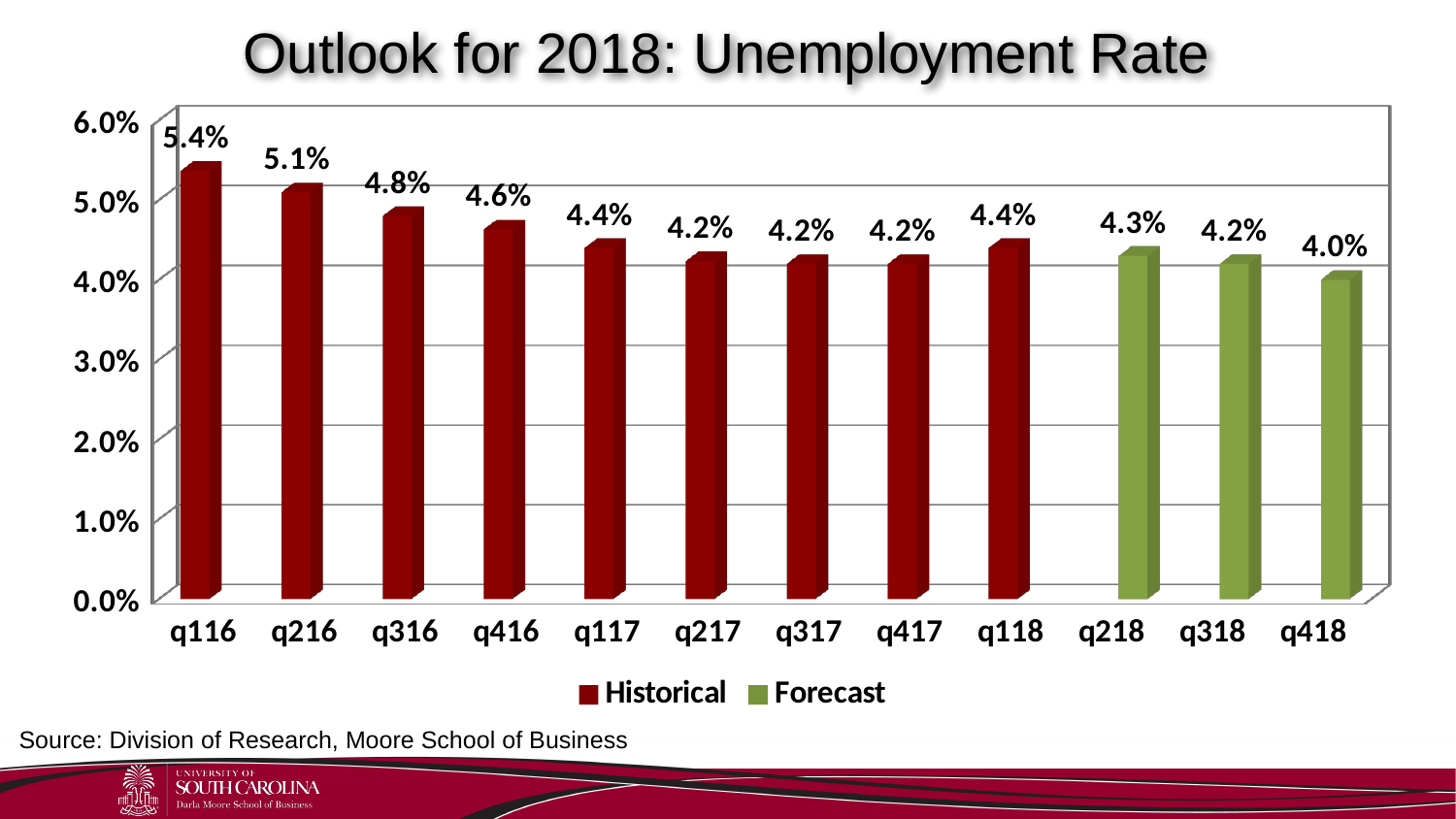
What is the unemployment rate shown for q118? 4.4% How many quarters are shown on the x axis? 12 Which series is shown in green in the legend? Forecast Do the unemployment rates generally rise or fall from q116 to q418? Fall What kind of chart is shown on the slide? Bar chart What is the unemployment rate shown for q116? 5.4% Which is larger, the unemployment rate for q216 or for q218? q216 Which quarter has the highest unemployment rate on the chart? q116 What is the forecast unemployment rate for q418? 4.0% Which quarter has the lowest unemployment rate on the chart? q418 How many series does the legend list? 2 What is the difference between the unemployment rate in q116 and q418? 1.4%